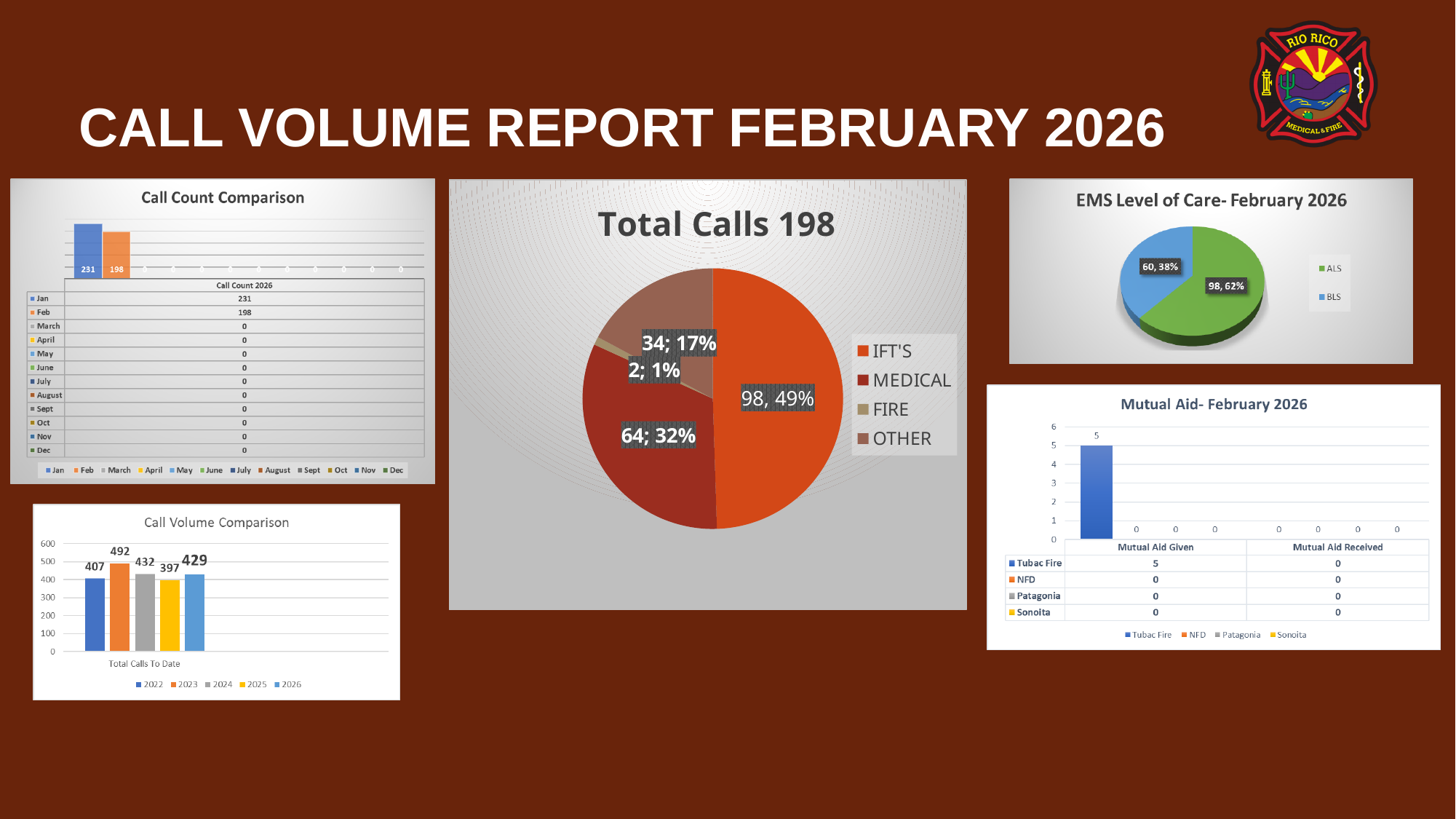
In the Call Volume Comparison chart, which year has the highest total calls to date? 2023 In the Call Volume Comparison chart, what is the value for 2023? 492 In the Total Calls 198 pie chart, how many calls are OTHER? 34 In the Call Count Comparison chart, what is the call count for Feb? 198 In the Call Count Comparison chart, what is the difference between the Jan and Feb call counts? 33 What kind of chart is the Mutual Aid- February 2026 chart? bar chart In the Call Volume Comparison chart, which year has the lowest total calls to date? 2025 In the Mutual Aid- February 2026 chart, what is the Mutual Aid Given value for Tubac Fire? 5 In the Total Calls 198 pie chart, what share of calls is MEDICAL? 32% In the Total Calls 198 pie chart, which category has the smallest slice? FIRE In the Call Volume Comparison chart, how many series does the legend list? 5 In the EMS Level of Care- February 2026 chart, what is the value for ALS? 98, 62%